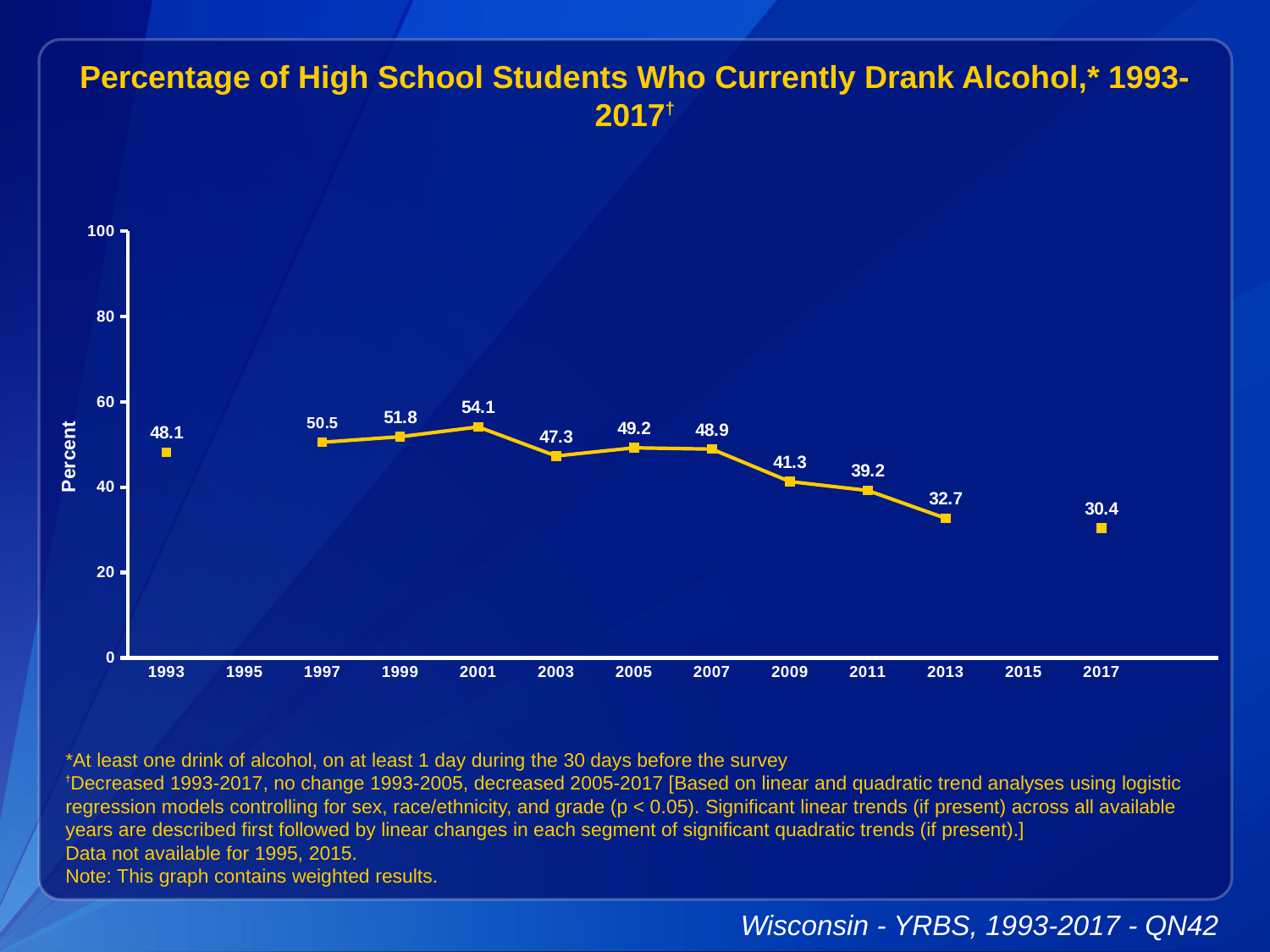
Which year had a higher percentage, 2009 or 2011? 2009 What is the label on the y axis of the chart? Percent Which year had the lowest percentage of students who currently drank alcohol? 2017 Which year had the highest percentage of students who currently drank alcohol? 2001 What is the difference between the 2001 value and the 2017 value? 23.7 How many years have data points plotted on the chart? 11 What kind of chart is shown on the slide? line chart Does the percentage rise or fall from 2005 to 2017? fall What was the percentage of high school students who currently drank alcohol in 2017? 30.4 What was the percentage of high school students who currently drank alcohol in 1993? 48.1 Is the value for 2013 greater or less than 40? less What was the percentage of high school students who currently drank alcohol in 2001? 54.1